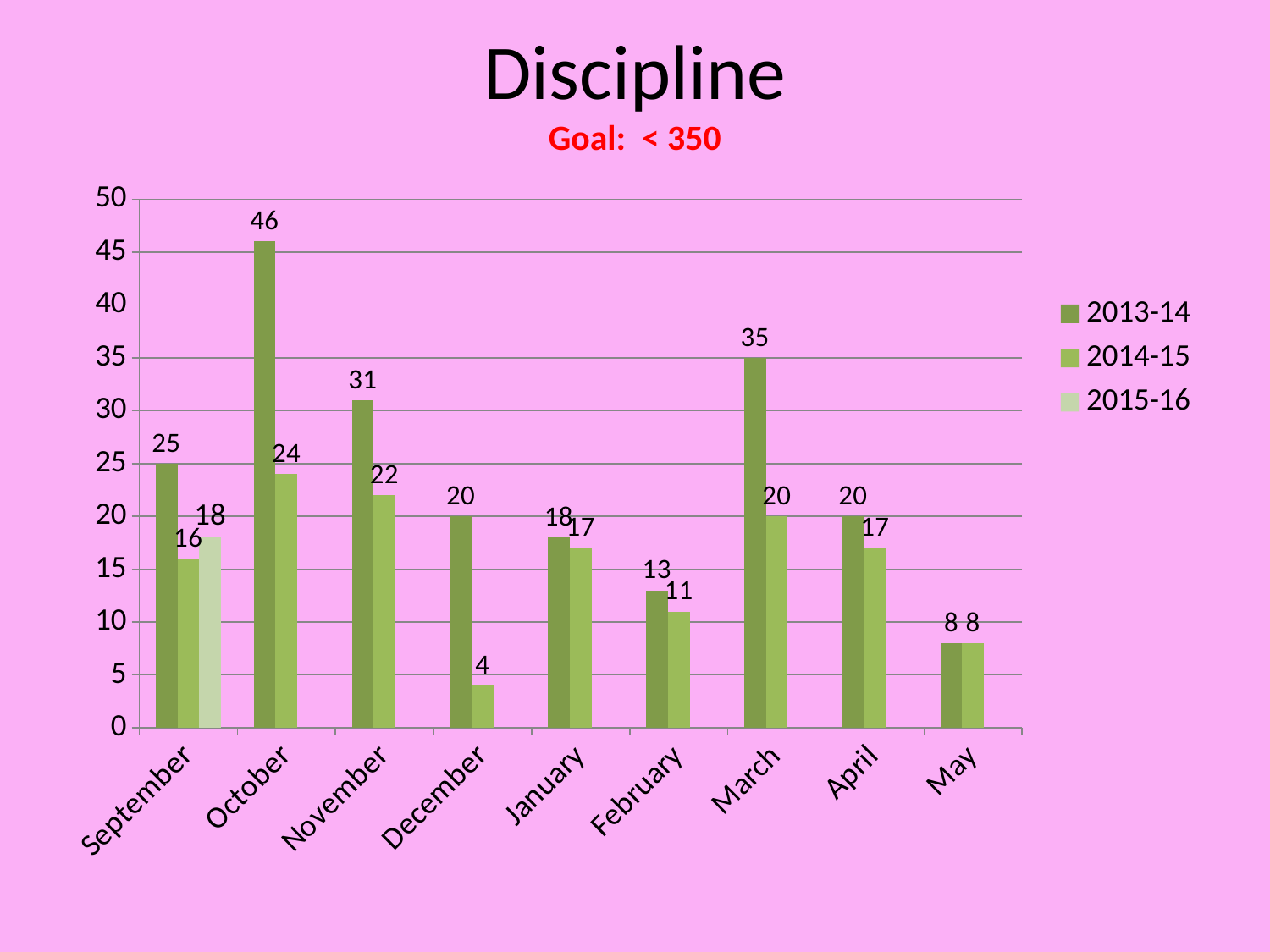
Which is larger in November: the 2013-14 value or the 2014-15 value? 2013-14 How many series does the legend list? 3 What is the value for 2013-14 in October? 46 Which month has the highest value for the 2013-14 series? October What kind of chart is shown on the slide? bar chart What is the value for 2015-16 in September? 18 How many months are shown on the x axis? 9 What goal is stated below the chart title? < 350 What is the difference between the 2013-14 and 2014-15 values in March? 15 What is the title of the chart? Discipline What is the value for 2014-15 in December? 4 Which month has the lowest value for the 2014-15 series? December